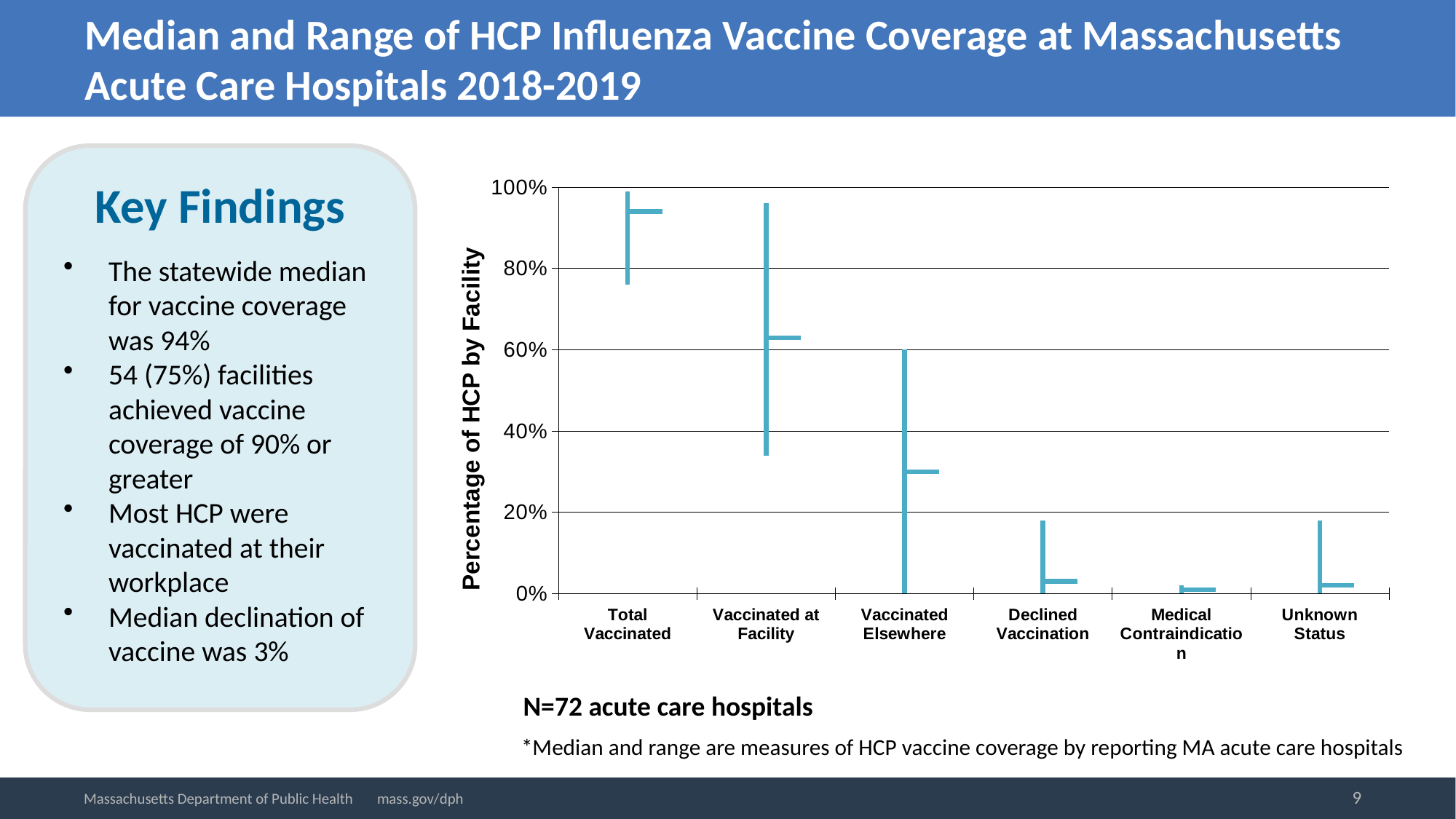
Is the median value for Declined Vaccination greater or less than 20%? less Is the median value for Total Vaccinated greater or less than 80%? greater What is the title of the vertical axis of the chart? Percentage of HCP by Facility Which has the larger median value, Vaccinated at Facility or Vaccinated Elsewhere? Vaccinated at Facility Is the median value for Vaccinated Elsewhere greater or less than 20%? greater How many acute care hospitals are included in the chart, according to the note below it? N=72 Which category has the highest median value in the chart? Total Vaccinated Do the median values generally rise or fall moving from left to right across the categories? fall How many categories are shown on the x axis of the chart? 6